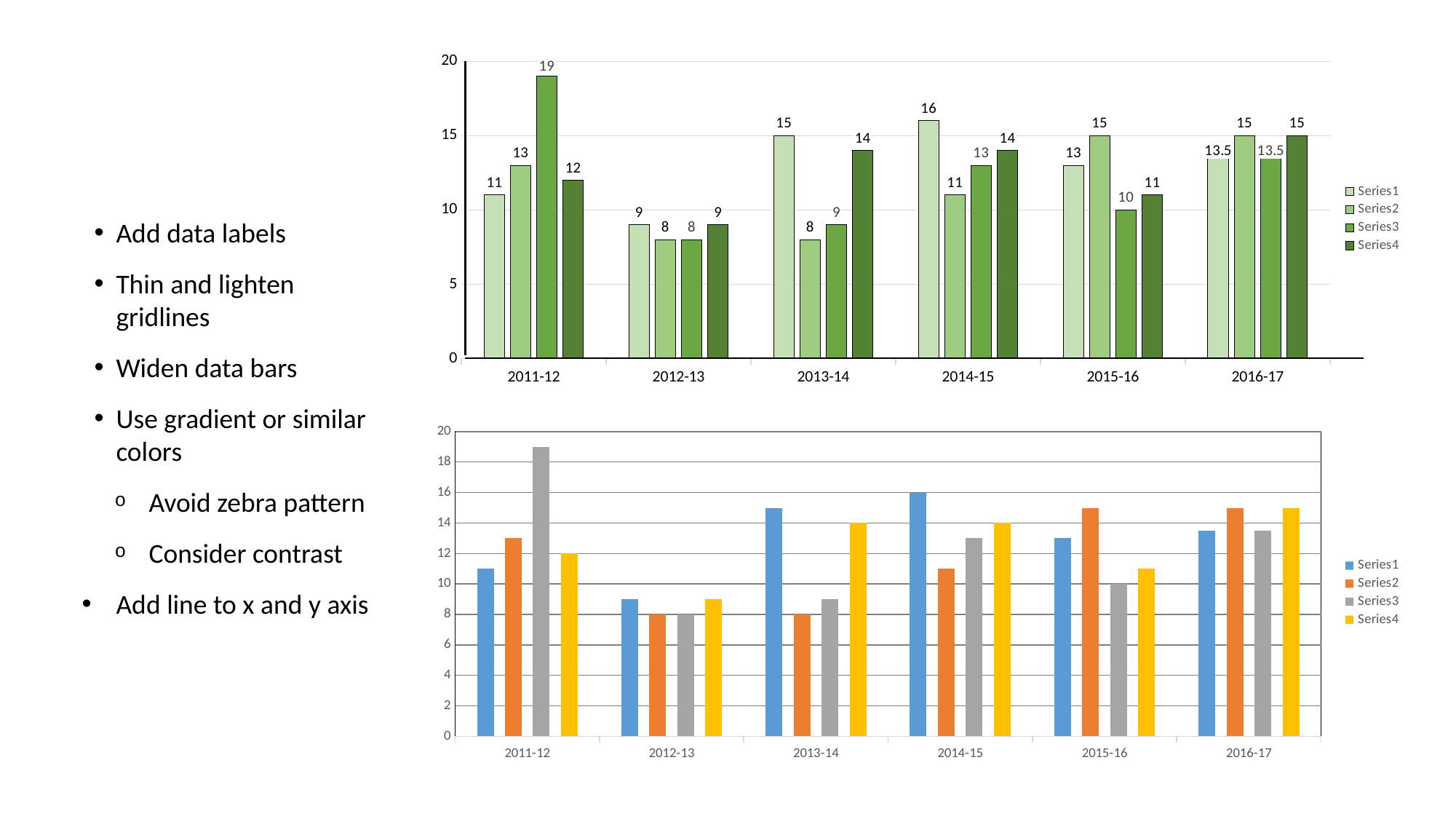
What kind of chart is the bottom chart? bar chart In the top chart, what is the value of Series3 for 2011-12? 19 In the top chart, which is larger for 2015-16: Series2 or Series4? Series2 In the top chart, which category has the highest Series1 value? 2014-15 How many categories are shown on the x axis of the top chart? 6 In the top chart, which category has the lowest Series2 value? 2012-13 and 2013-14 (both 8) How many series does the legend of the bottom chart list? 4 In the top chart, what is the value of Series1 for 2016-17? 13.5 In the top chart, what is the difference between Series3 and Series1 for 2011-12? 8 In the bottom chart, is the value of Series2 for 2014-15 greater or less than 12? less In the bottom chart, what colour represents Series4? yellow In the bottom chart, is the value of Series3 for 2011-12 greater or less than 16? greater